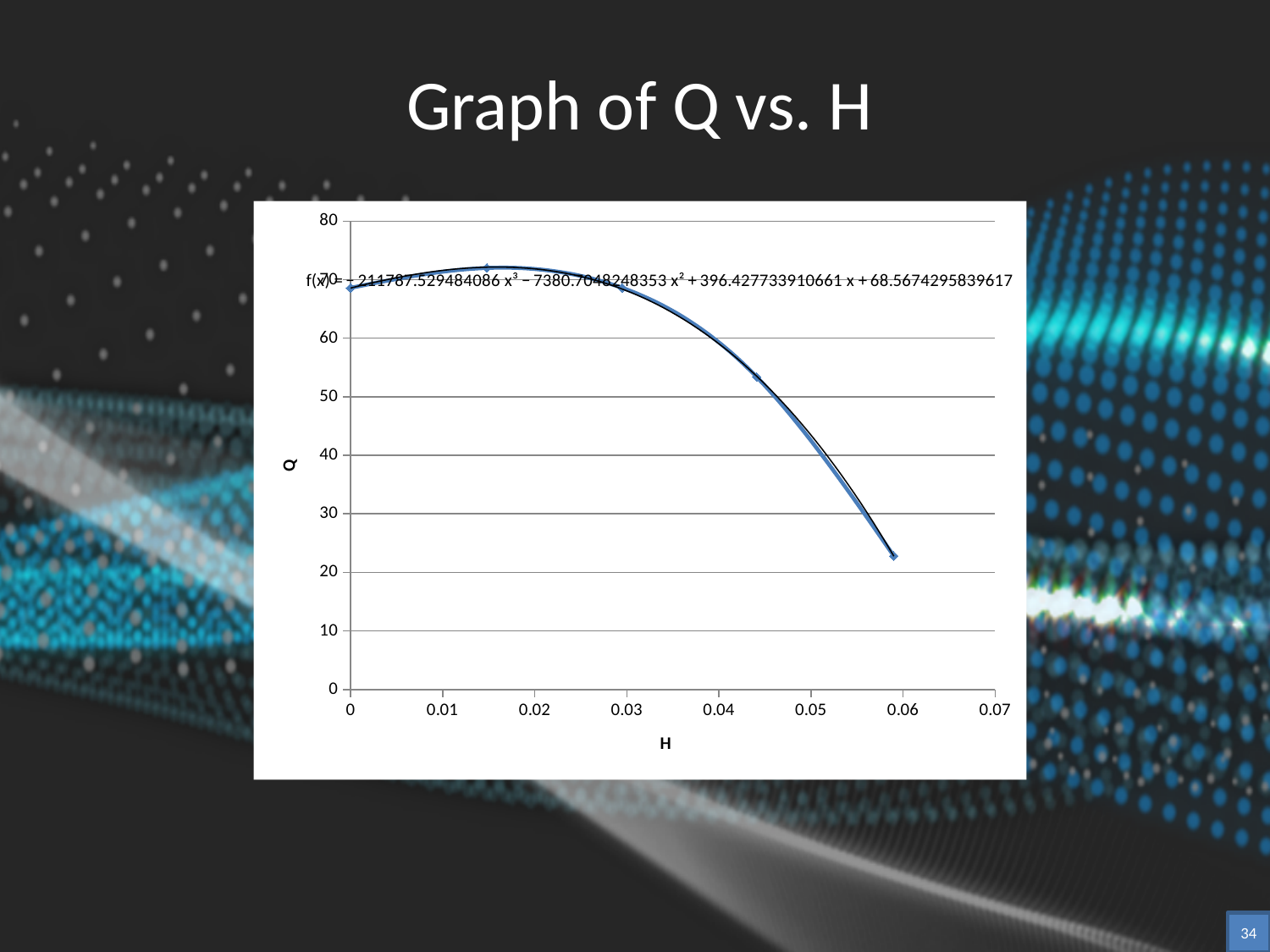
Which is larger, the Q value at H = 0 or the Q value at the point near H = 0.044? the Q value at H = 0 Is the value of Q at H = 0 greater or less than 60? greater How does Q change as H increases along the x axis? rises slightly then falls What kind of chart is shown on the slide? scatter chart with a fitted curve Which data point has the lowest Q value? the point near H = 0.06 Is the value of Q for the last data point (near H = 0.06) greater or less than 30? less What is the title of the x axis? H Is the value of Q for the data point near H = 0.03 greater or less than 60? greater How many data points are plotted on the chart? 5 What is the title of the y axis? Q